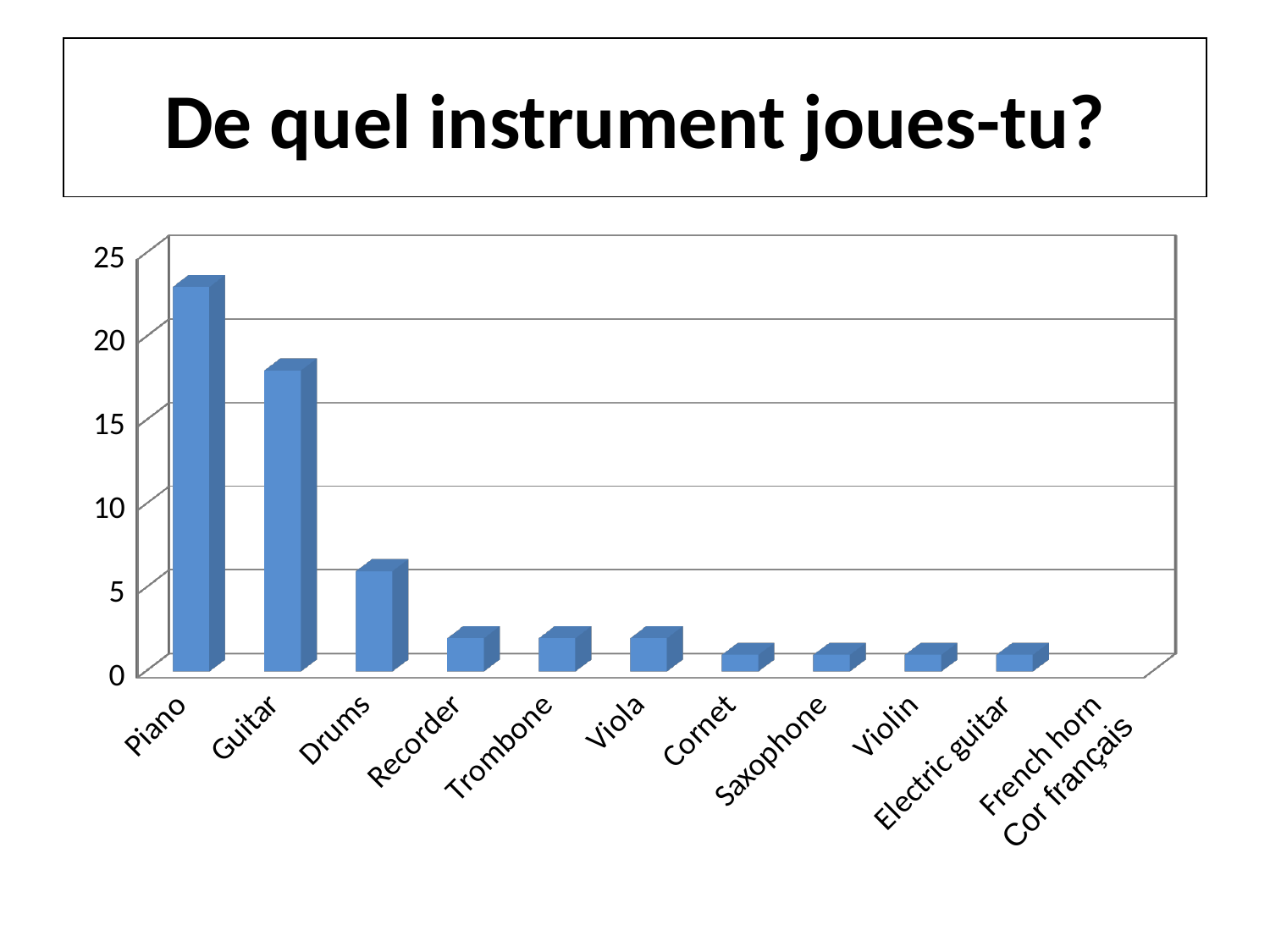
What kind of chart is shown on the slide? bar chart What is the title of the slide? De quel instrument joues-tu? Is the value for Recorder greater or less than 5? less Is the value for Guitar greater or less than 20? less Is the value for Piano greater or less than 20? greater Which is larger, the value for Guitar or the value for Drums? Guitar How many instrument categories are shown on the x axis? 11 Do the values generally rise or fall moving from left to right along the x axis? fall Which instrument has the highest bar? Piano